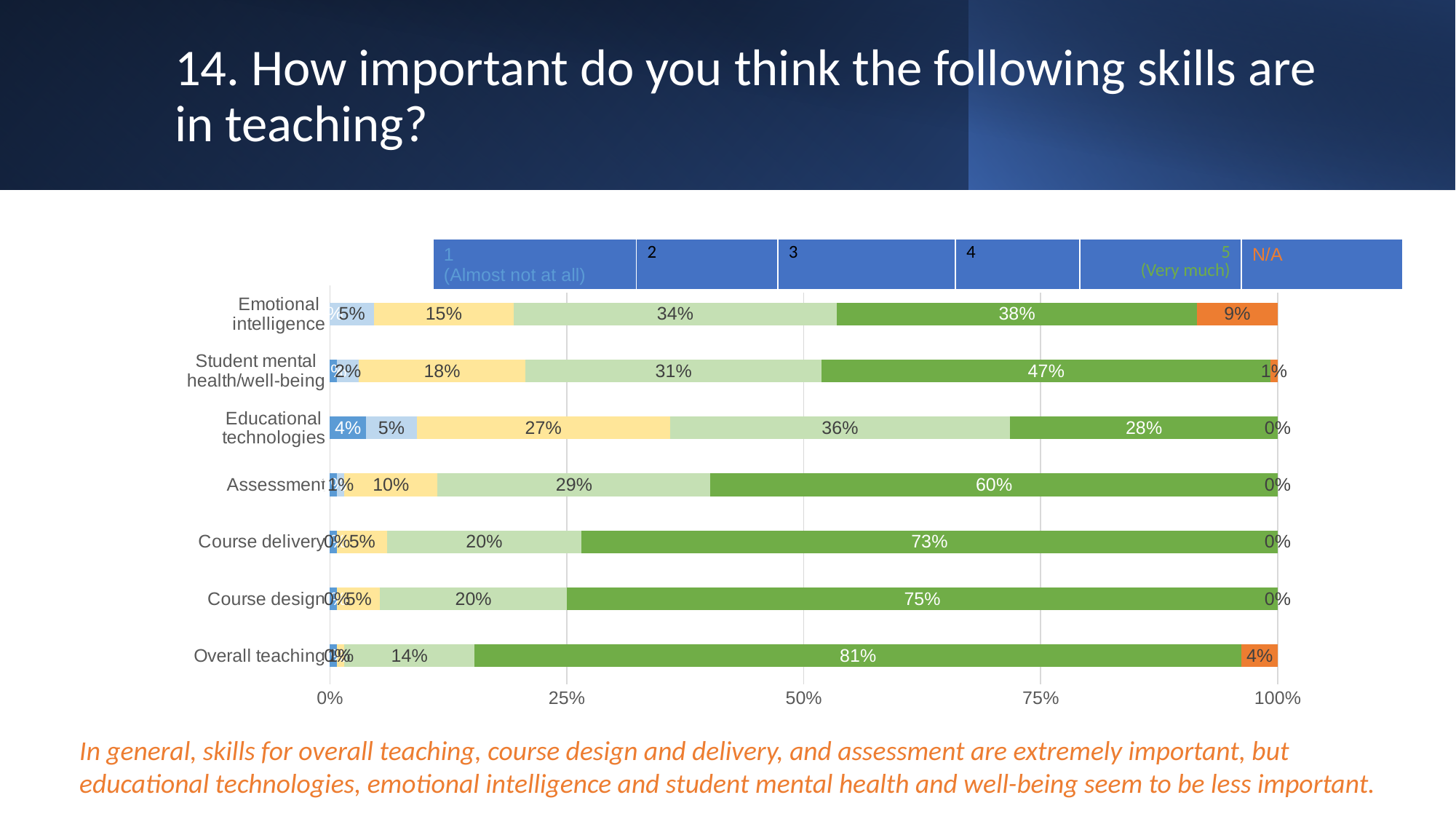
Which skill has the lowest percentage of 5 (Very much) ratings? Educational technologies How many series does the legend list? 6 What is the difference between the 5 (Very much) percentages for Course design and Course delivery? 2% What kind of chart is shown on the slide? Stacked bar chart What percentage of respondents rated Educational technologies as 3? 27% What colour represents the N/A series in the chart? Orange Which has a larger 4 rating percentage: Emotional intelligence or Student mental health/well-being? Emotional intelligence What is the N/A percentage for Emotional intelligence? 9% What percentage of respondents rated Assessment as 5 (Very much)? 60% Which skill has the highest percentage of 5 (Very much) ratings? Overall teaching How many skill categories are plotted on the chart? 7 What percentage of respondents rated Overall teaching as 5 (Very much)? 81%